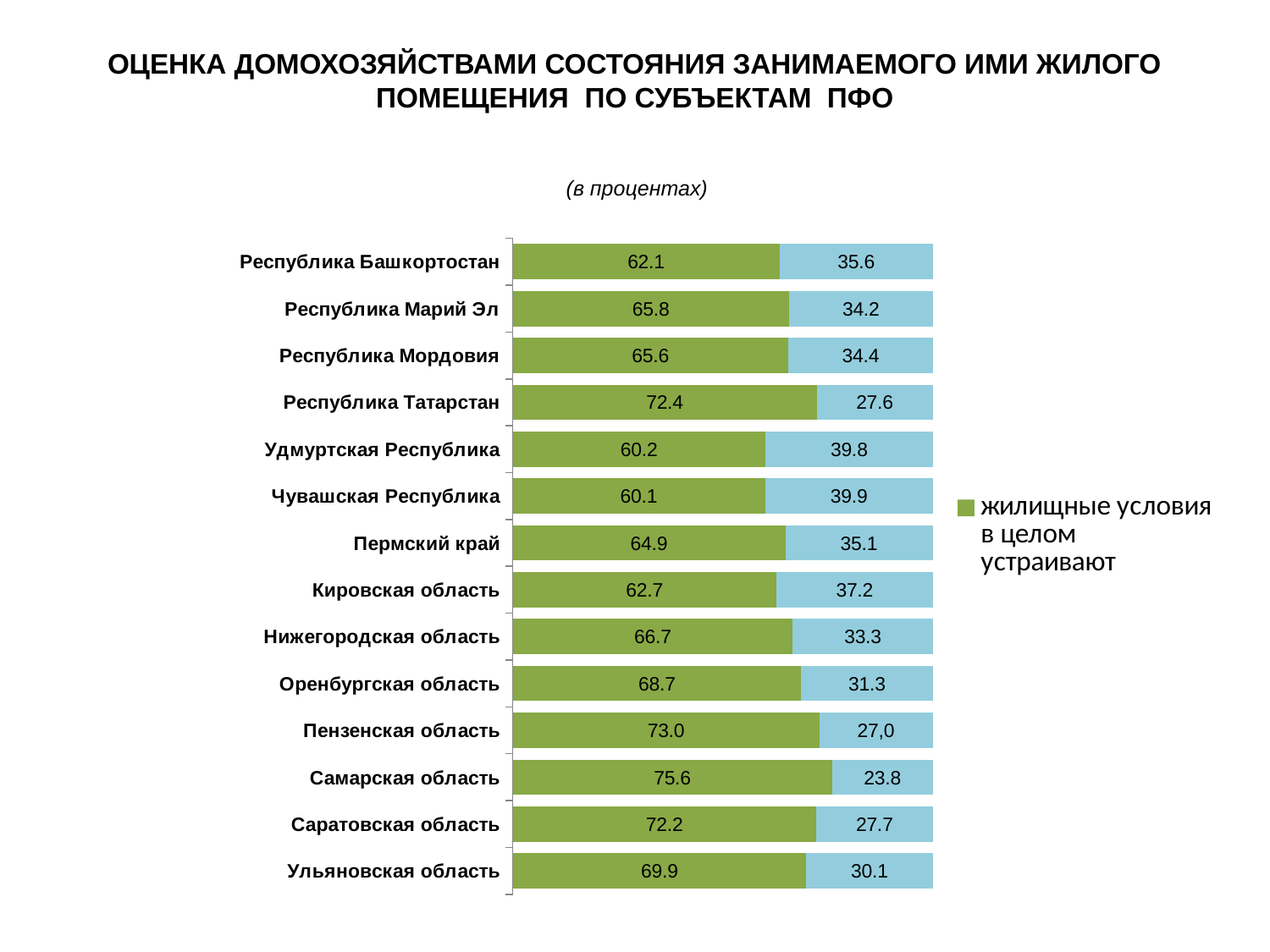
What kind of chart is shown on the slide? bar chart What is the total of the two segments for Республика Башкортостан? 97.7 What is the value of the blue segment for Пензенская область? 27,0 What is the value of the green segment (жилищные условия в целом устраивают) for Республика Татарстан? 72.4 How many series does the legend list? 1 Which region has the lowest value for the blue segment? Самарская область Which region has a larger green segment value: Пермский край or Кировская область? Пермский край What is the value of the blue segment for Удмуртская Республика? 39.8 What is the difference between the green segment values for Республика Татарстан and Республика Башкортостан? 10.3 How many regions (categories) are shown in the chart? 14 Which region has the highest value for the green segment (жилищные условия в целом устраивают)? Самарская область What is the value of the green segment for Ульяновская область? 69.9